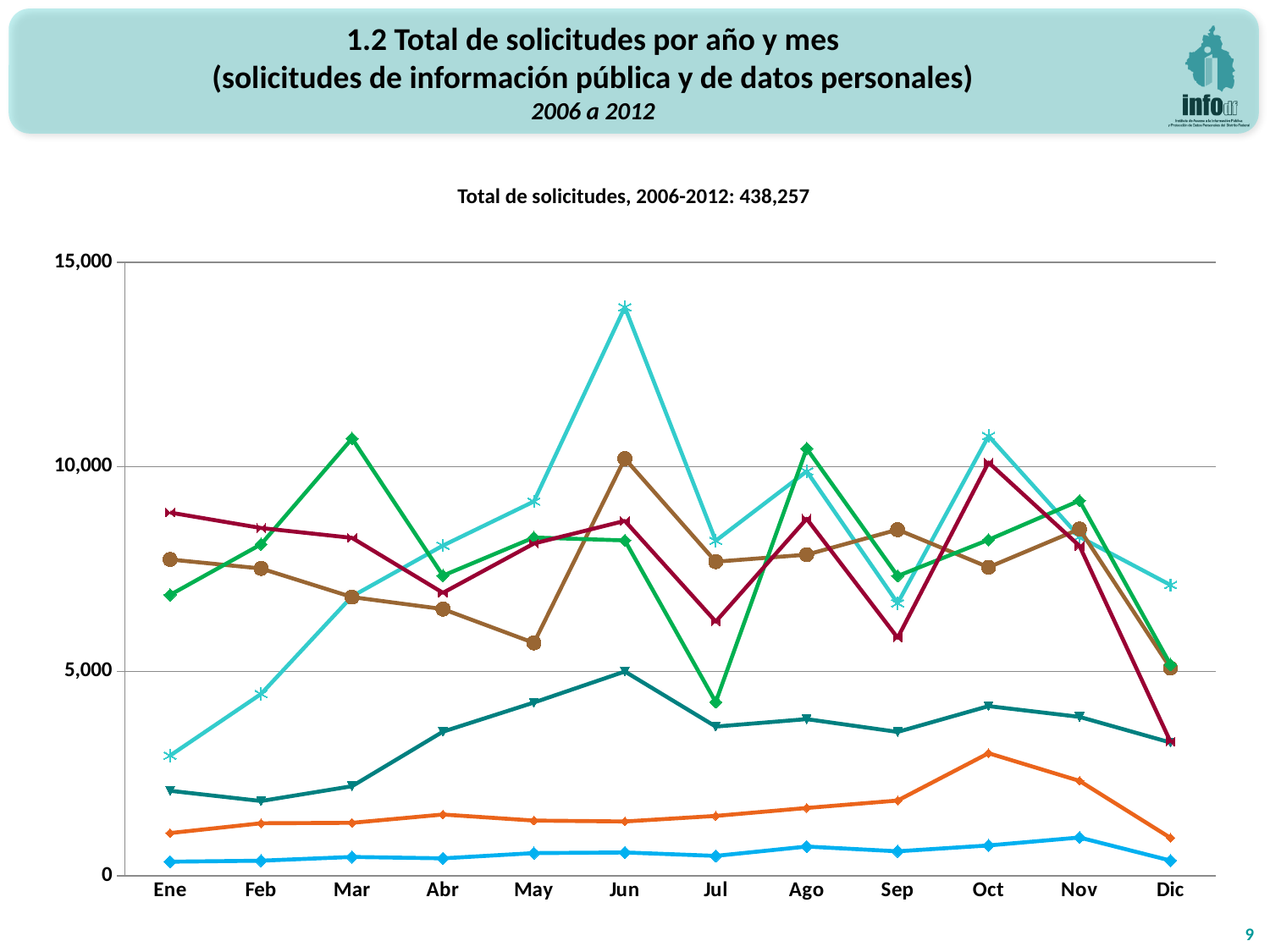
Is the value of the light cyan line in Jun greater or less than 10,000? greater In which month does the brown line reach its lowest value? Dic Is the value of the dark red line in Dic greater or less than 5,000? less Does the orange line rise or fall from Oct to Dic? fall In which month does the orange line reach its highest value? Oct In which month does the light cyan line reach its highest value? Jun In Jun, which line has the larger value: the light cyan line or the brown line? the light cyan line Is the value of the green line in Mar greater or less than 10,000? greater What total number of solicitudes for 2006-2012 is printed above the chart? 438,257 How many months are shown along the x axis of the chart? 12 What kind of chart is shown on the slide? line chart